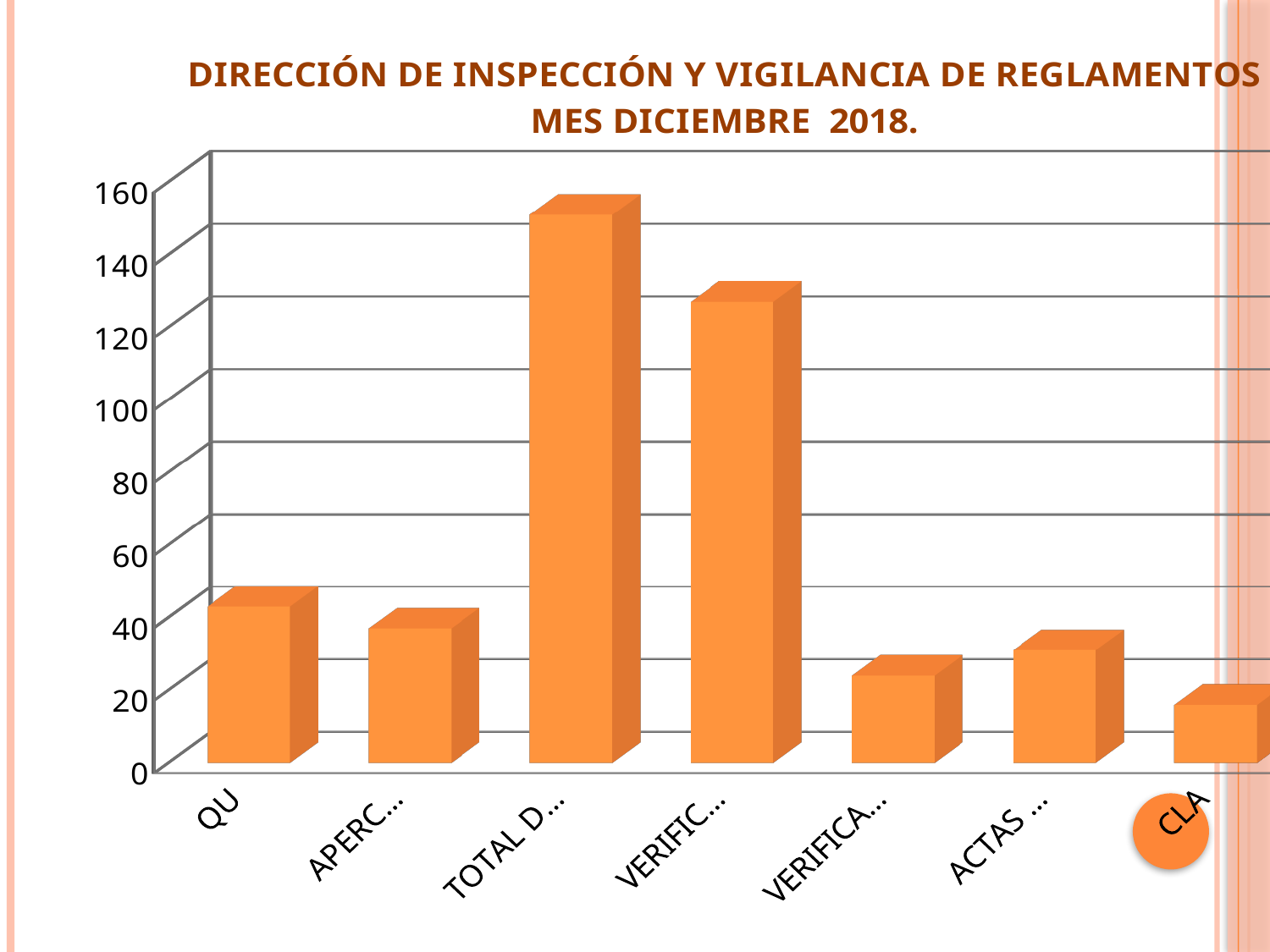
Is the value for VERIFIC... (the fourth bar) greater or less than 120? greater Which is larger, the value for QU or the value for APERC...? QU Which category has the highest bar? TOTAL D... (the third bar) What kind of chart is shown on the slide? bar chart What is the title of the chart? DIRECCIÓN DE INSPECCIÓN Y VIGILANCIA DE REGLAMENTOS MES DICIEMBRE 2018. Which is larger, the value for TOTAL D... or the value for VERIFIC...? TOTAL D... Is the value for TOTAL D... greater or less than 140? greater What colour are the bars in the chart? orange Which category has the lowest bar? CLA (the last bar) Is the value for CLA greater or less than 40? less How many bars (categories) does the chart show? 7